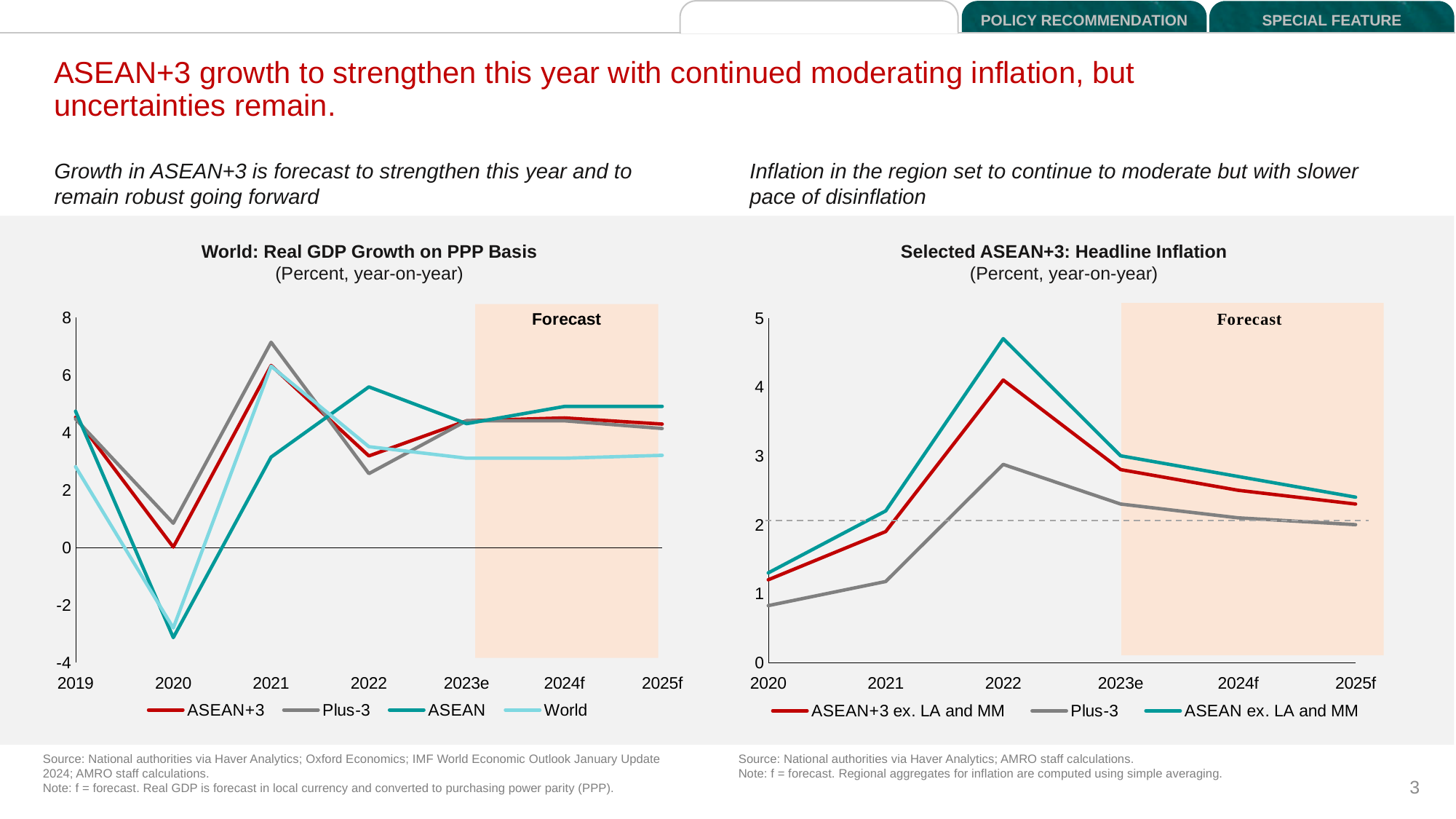
In the 'World: Real GDP Growth on PPP Basis' chart, which series has the lowest value in 2020? ASEAN How many series does the legend of the 'World: Real GDP Growth on PPP Basis' chart list? 4 In the 'World: Real GDP Growth on PPP Basis' chart, is the value for Plus-3 in 2021 greater or less than 6? greater In the 'Selected ASEAN+3: Headline Inflation' chart, in which year does ASEAN ex. LA and MM reach its highest value? 2022 In the 'World: Real GDP Growth on PPP Basis' chart, which is higher in 2022, ASEAN or Plus-3? ASEAN What does the shaded area on the right side of each chart represent? Forecast What type of chart is the 'World: Real GDP Growth on PPP Basis' chart? Line chart In the 'World: Real GDP Growth on PPP Basis' chart, is the value for ASEAN in 2020 greater or less than -2? less In the 'World: Real GDP Growth on PPP Basis' chart, which series has the highest value in 2021? Plus-3 In the 'Selected ASEAN+3: Headline Inflation' chart, is the value for ASEAN ex. LA and MM in 2022 greater or less than 4? greater How many years are shown on the x axis of the 'Selected ASEAN+3: Headline Inflation' chart? 6 In the 'Selected ASEAN+3: Headline Inflation' chart, does the ASEAN+3 ex. LA and MM line rise or fall from 2022 to 2025f? Fall